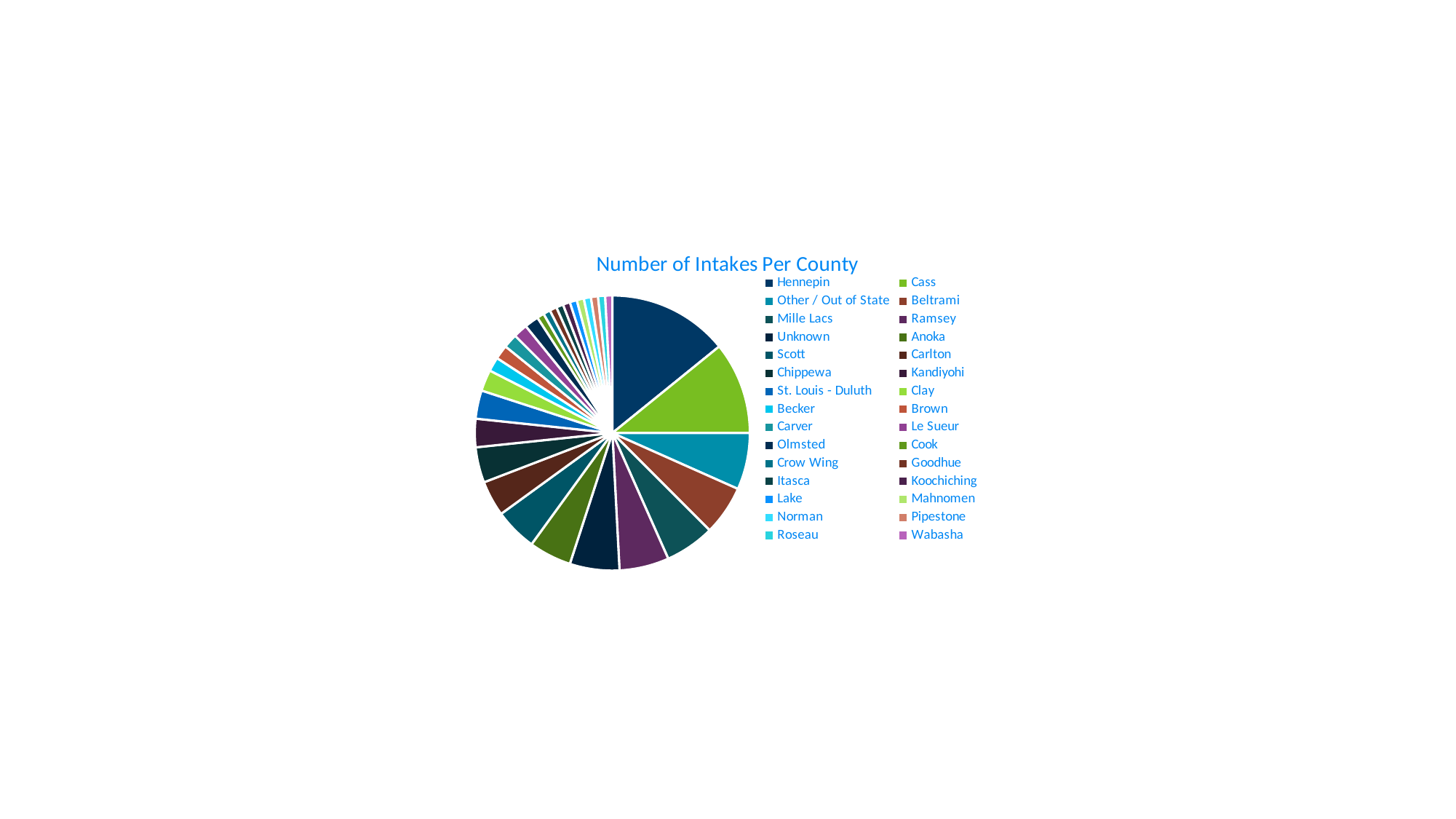
Which slice is larger, Beltrami or Norman? Beltrami Which slice is larger, Cass or Other / Out of State? Cass How many counties/categories does the chart's legend list? 30 Which slice is larger, Hennepin or Wabasha? Hennepin Which county has the largest slice of the pie? Hennepin What kind of chart is shown on the slide? pie chart Which county is listed first in the legend? Hennepin What is the title of the chart? Number of Intakes Per County